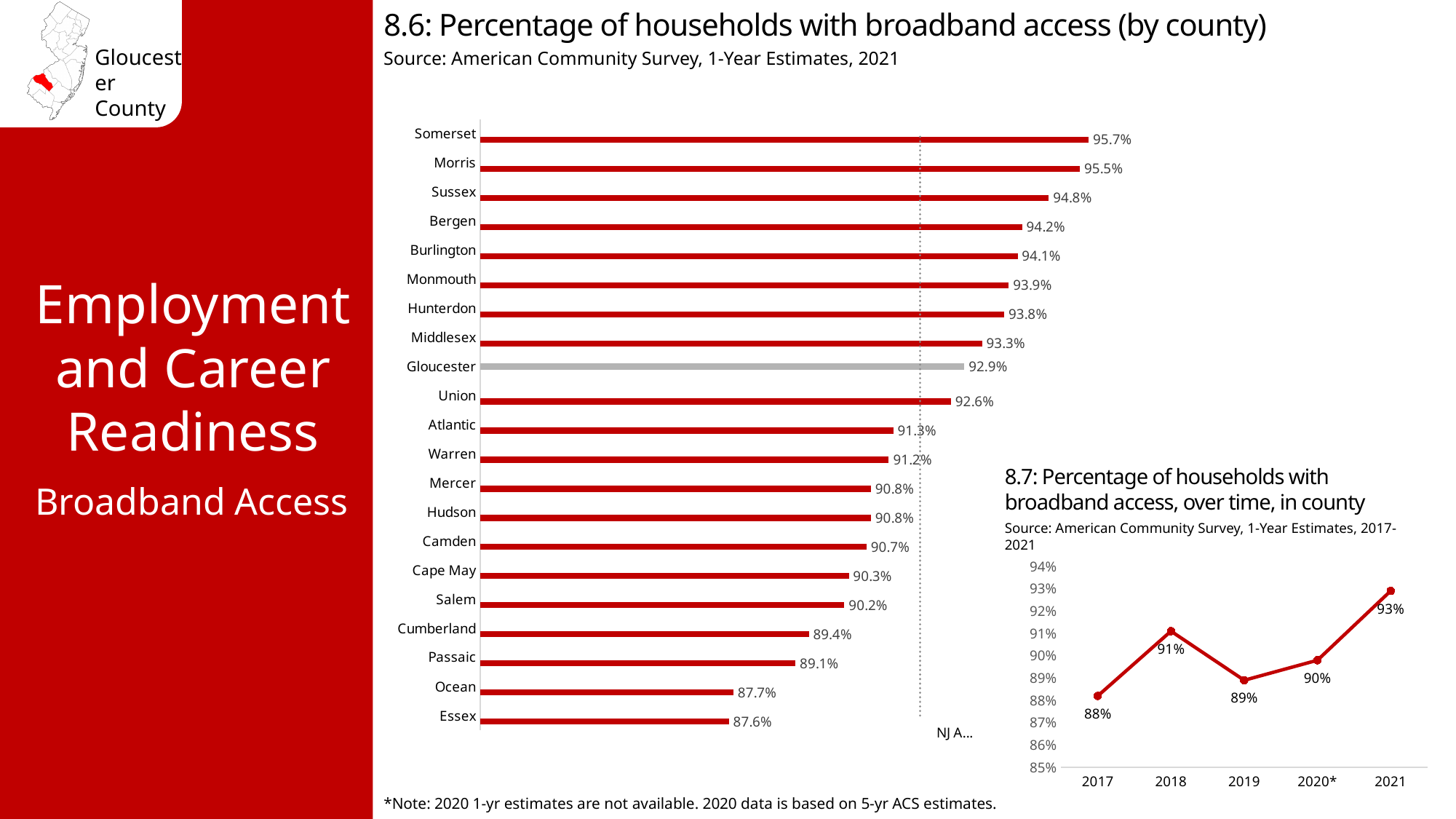
In chart 8.6 (by county), which county has the lowest percentage of households with broadband access? Essex In chart 8.6 (by county), what is the value for Cumberland? 89.4% In chart 8.7 (broadband access over time in county), what is the difference between the 2021 and 2017 values? 5 percentage points In chart 8.6 (by county), how many counties are shown? 21 In chart 8.6 (by county), what is the difference between the values for Somerset and Essex? 8.1 percentage points In chart 8.6 (by county), which has a higher value, Bergen or Camden? Bergen In chart 8.6 (by county), which county has the highest percentage of households with broadband access? Somerset In chart 8.6 (Percentage of households with broadband access by county), what is the value for Gloucester? 92.9% What kind of chart is chart 8.7 (Percentage of households with broadband access over time in county)? Line chart What kind of chart is chart 8.6 (Percentage of households with broadband access by county)? Bar chart In chart 8.7 (broadband access over time in county), what is the value for 2019? 89% In chart 8.7 (broadband access over time in county), which year has the highest value? 2021